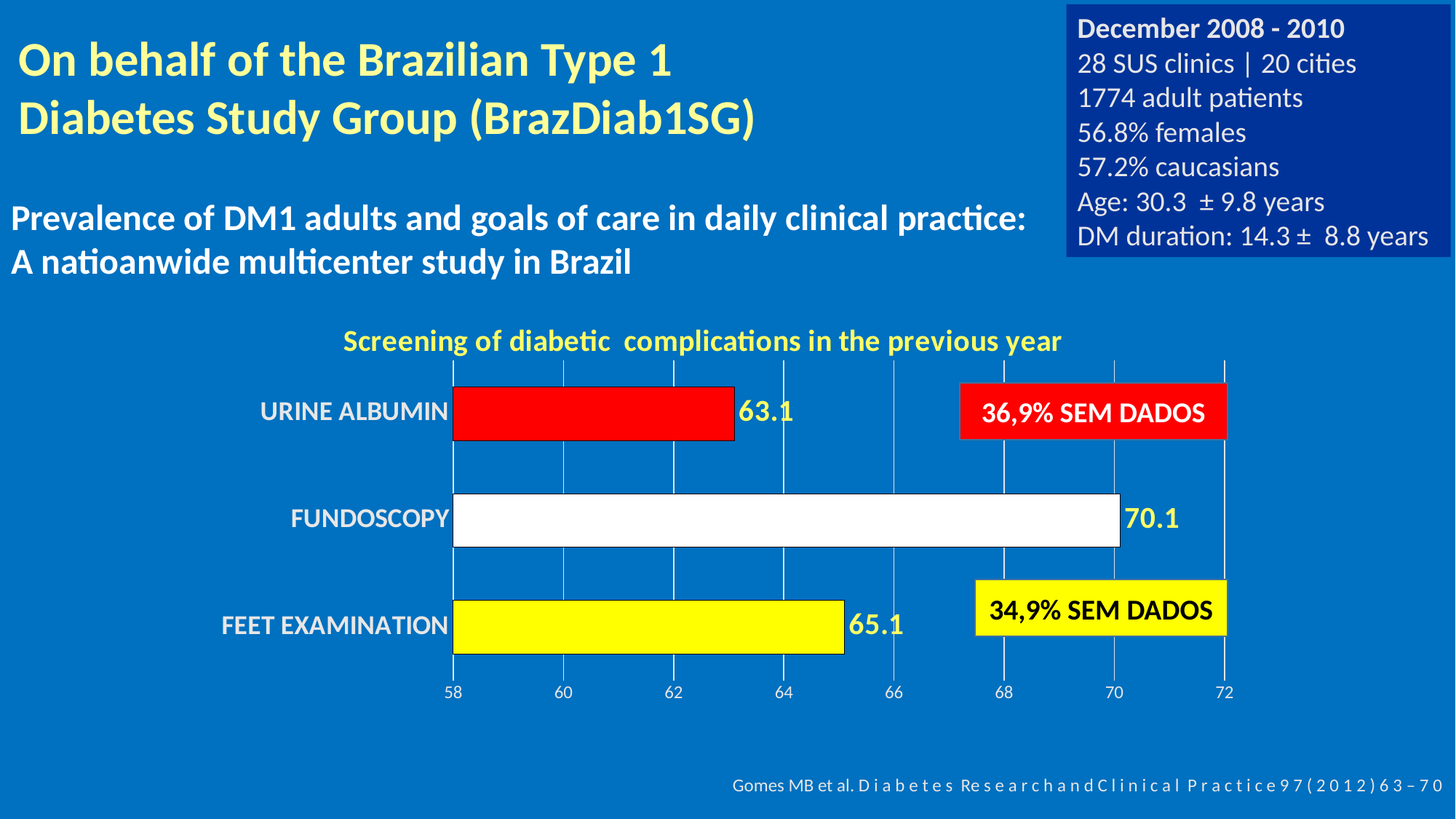
What is the value for FEET EXAMINATION? 65.1 How many categories are shown in the chart? 3 What is the value for URINE ALBUMIN? 63.1 What is the difference between the values for FUNDOSCOPY and URINE ALBUMIN? 7.0 Which category has the lowest value? URINE ALBUMIN Is the value for FUNDOSCOPY greater or less than 68? greater Which category has the highest value? FUNDOSCOPY What is the value for FUNDOSCOPY? 70.1 What is the title of the chart? Screening of diabetic complications in the previous year Which is larger, the value for FEET EXAMINATION or the value for URINE ALBUMIN? FEET EXAMINATION What is the difference between the values for FEET EXAMINATION and URINE ALBUMIN? 2.0 What kind of chart is shown on the slide? bar chart